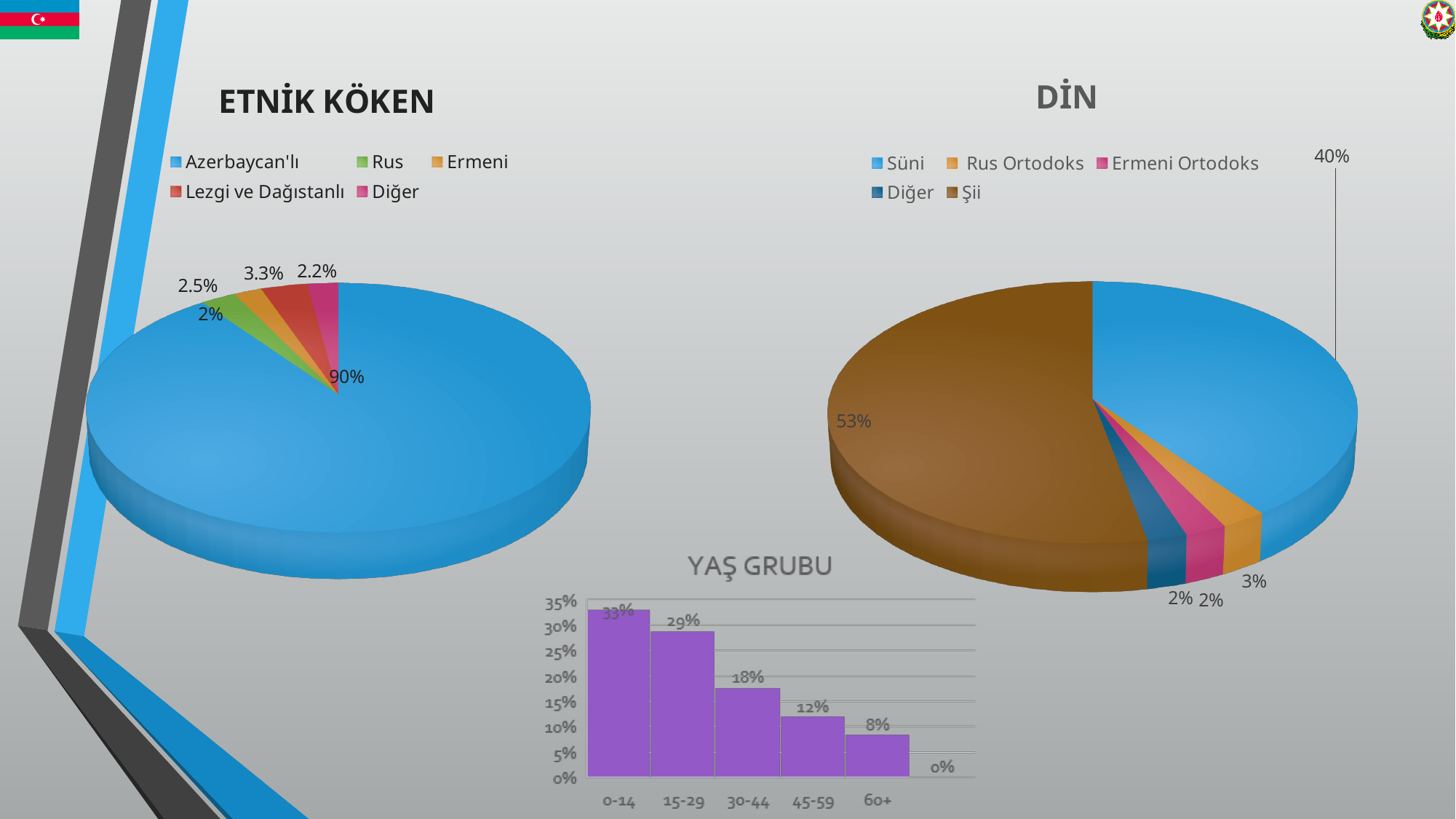
In the DİN pie chart, which is larger, Rus Ortodoks or Ermeni Ortodoks? Rus Ortodoks In the YAŞ GRUBU chart, what is the value for the 30-44 age group? 18% What kind of chart is the YAŞ GRUBU chart? Bar chart How many series does the legend of the ETNİK KÖKEN pie chart list? 5 In the YAŞ GRUBU chart, do the values rise or fall from 0-14 to 60+? Fall In the DİN pie chart, what share is shown for Şii? 53% In the ETNİK KÖKEN pie chart, what share is shown for Azerbaycan'lı? 90% In the YAŞ GRUBU chart, which age group has the highest value? 0-14 In the DİN pie chart, what is the difference between the Şii and Süni shares? 13% In the DİN pie chart, what share is shown for Süni? 40% In the ETNİK KÖKEN pie chart, what share is shown for Lezgi ve Dağıstanlı? 3.3% In the ETNİK KÖKEN pie chart, which category has the largest share? Azerbaycan'lı